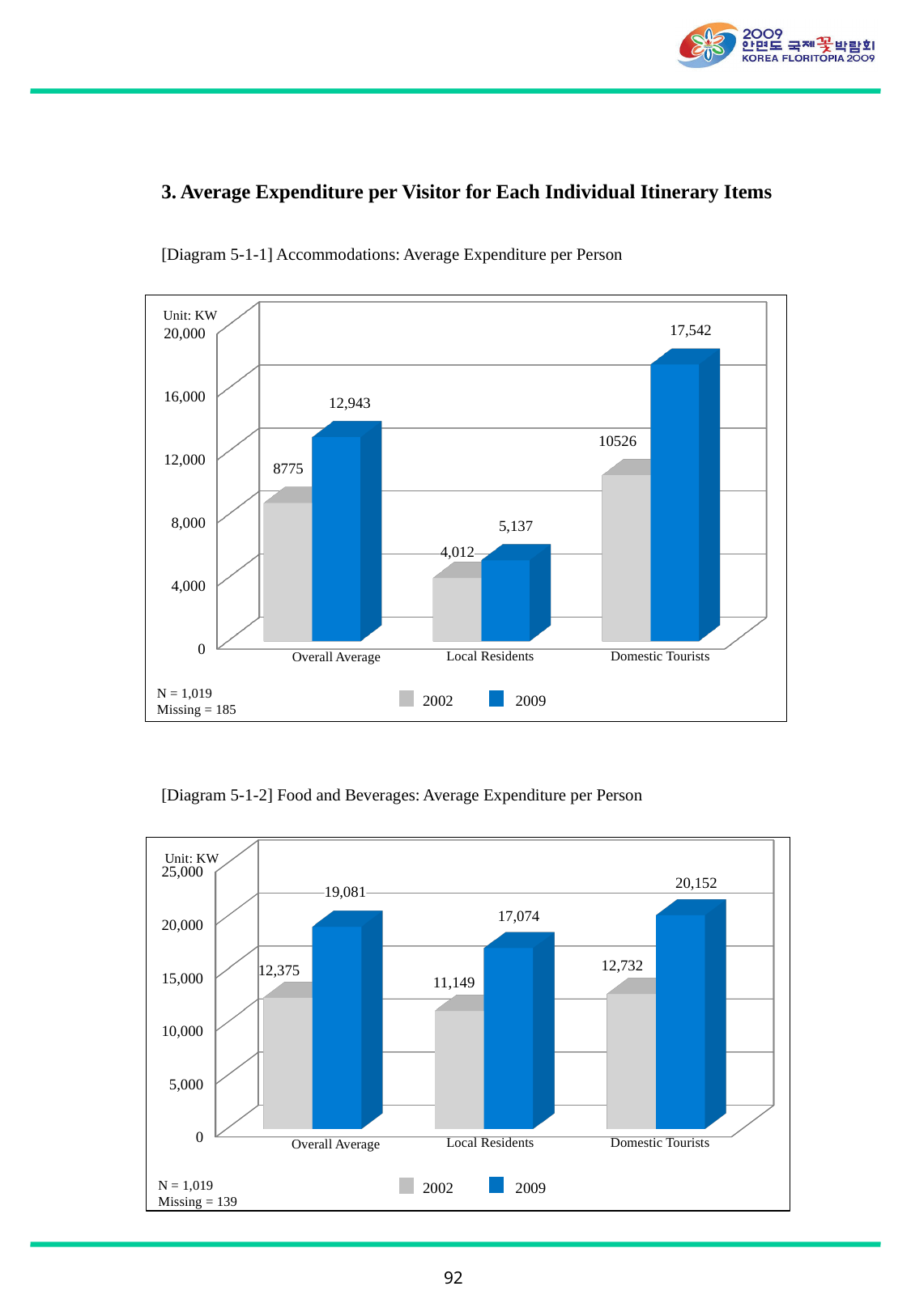
In the Food and Beverages chart, which is larger: the 2002 value for Overall Average or the 2002 value for Domestic Tourists? Domestic Tourists In the Accommodations chart, what is the 2002 value for Local Residents? 4,012 In the Accommodations chart, what is the difference between the 2009 and 2002 values for Overall Average? 4,168 What type of chart is the Food and Beverages chart? Bar chart In the Food and Beverages chart, what is the difference between the 2009 and 2002 values for Domestic Tourists? 7,420 How many series does the legend of the Food and Beverages chart list? 2 In the Food and Beverages chart, what is the 2009 value for Local Residents? 17,074 In the Accommodations chart, which category has the lowest 2009 value? Local Residents In the Food and Beverages chart, which category has the highest 2009 value? Domestic Tourists How many categories are shown on the x axis of the Accommodations chart? 3 In the Accommodations chart, is the 2002 value for Domestic Tourists greater or less than 8,000? greater In the Accommodations chart, what is the 2009 average expenditure per person for Domestic Tourists? 17,542